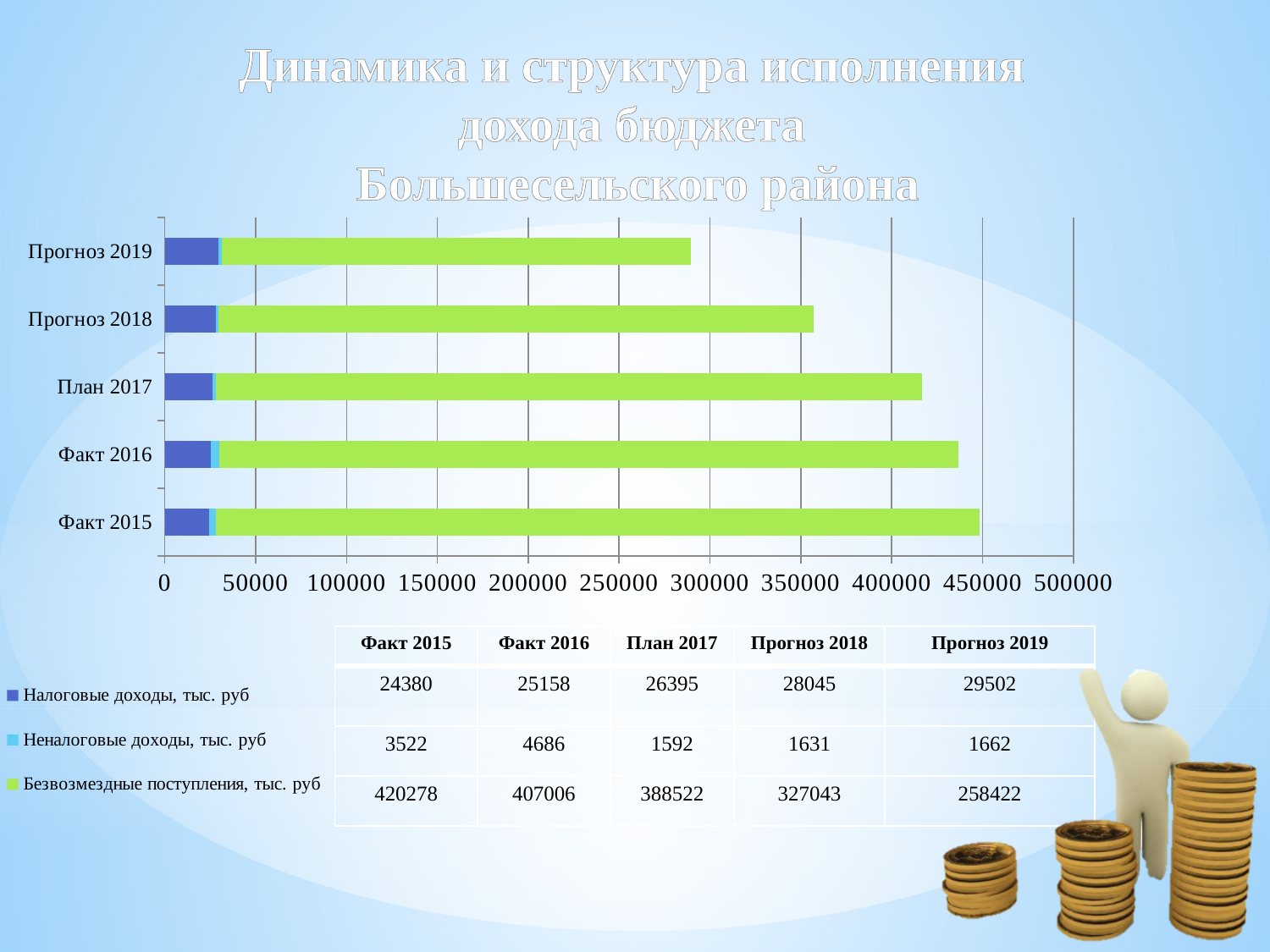
What is the difference between Безвозмездные поступления, тыс. руб for Факт 2015 and Прогноз 2019? 161856 What is the value of Налоговые доходы, тыс. руб for Факт 2015? 24380 What is the value of Безвозмездные поступления, тыс. руб for Прогноз 2019? 258422 Which is larger: Налоговые доходы, тыс. руб for Прогноз 2018 or for План 2017? Прогноз 2018 How many categories are shown on the chart? 5 How many series does the legend list? 3 What kind of chart is shown on the slide? Stacked bar chart What is the total of the stacked bar for Факт 2015? 448180 Which category has the highest value for Безвозмездные поступления, тыс. руб? Факт 2015 Do the values for Безвозмездные поступления, тыс. руб rise or fall from Факт 2015 to Прогноз 2019? Fall Which category has the lowest value for Неналоговые доходы, тыс. руб? План 2017 What is the value of Неналоговые доходы, тыс. руб for Факт 2016? 4686